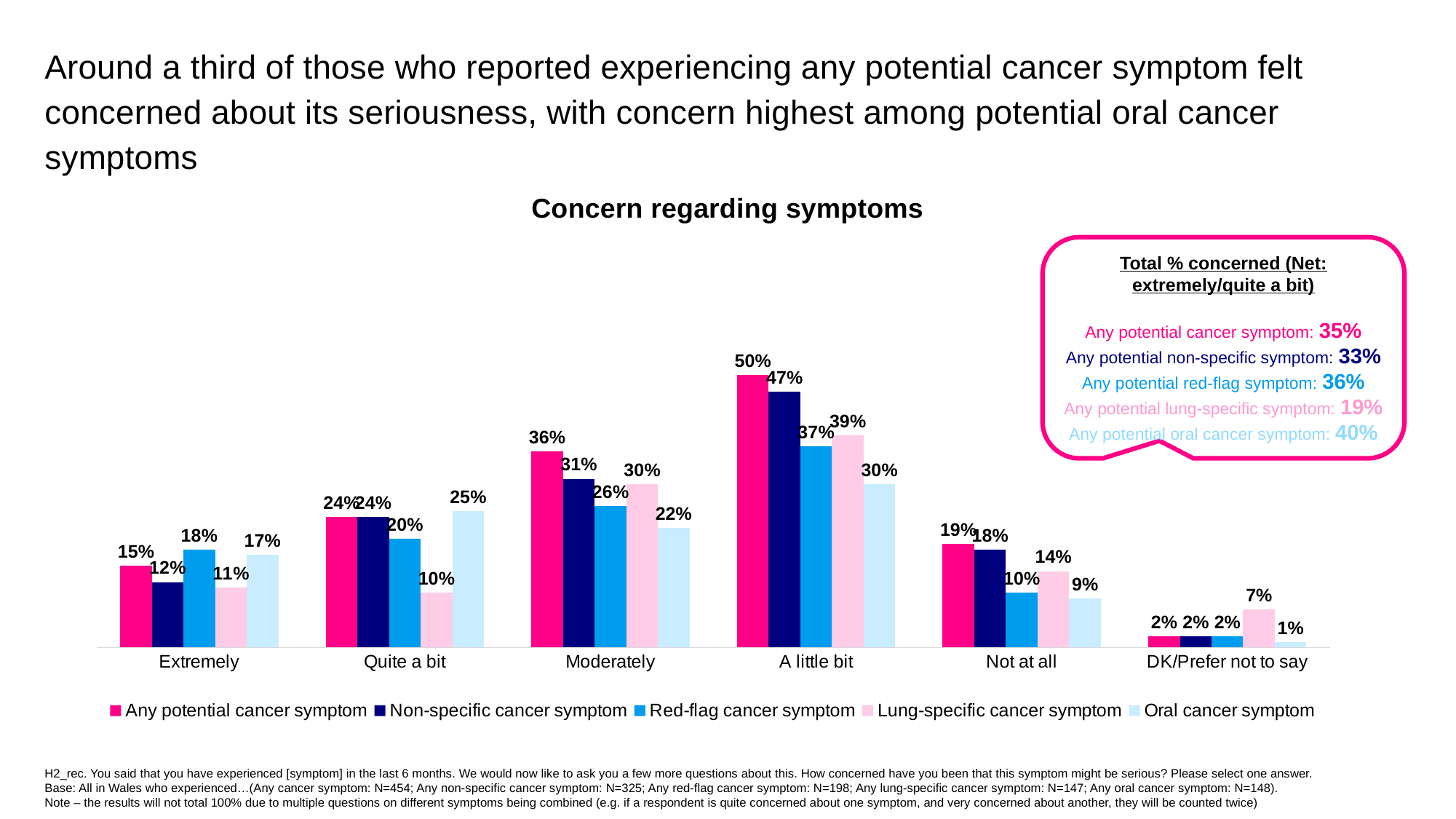
What is the value for Oral cancer symptom in the 'Quite a bit' category? 25% Which series has the lowest value in the 'Not at all' category? Oral cancer symptom Which is larger in the 'Extremely' category: Red-flag cancer symptom or Lung-specific cancer symptom? Red-flag cancer symptom How many series does the legend list? 5 What type of chart is shown on the slide? bar chart What is the difference between the Any potential cancer symptom and Non-specific cancer symptom values in the 'A little bit' category? 3% What is the value for Lung-specific cancer symptom in the 'DK/Prefer not to say' category? 7% What is the value for Any potential cancer symptom in the 'A little bit' category? 50% What is the value for Red-flag cancer symptom in the 'Moderately' category? 26% How many categories are shown on the x axis? 6 What is the title of the chart? Concern regarding symptoms Which series has the highest value in the 'Moderately' category? Any potential cancer symptom